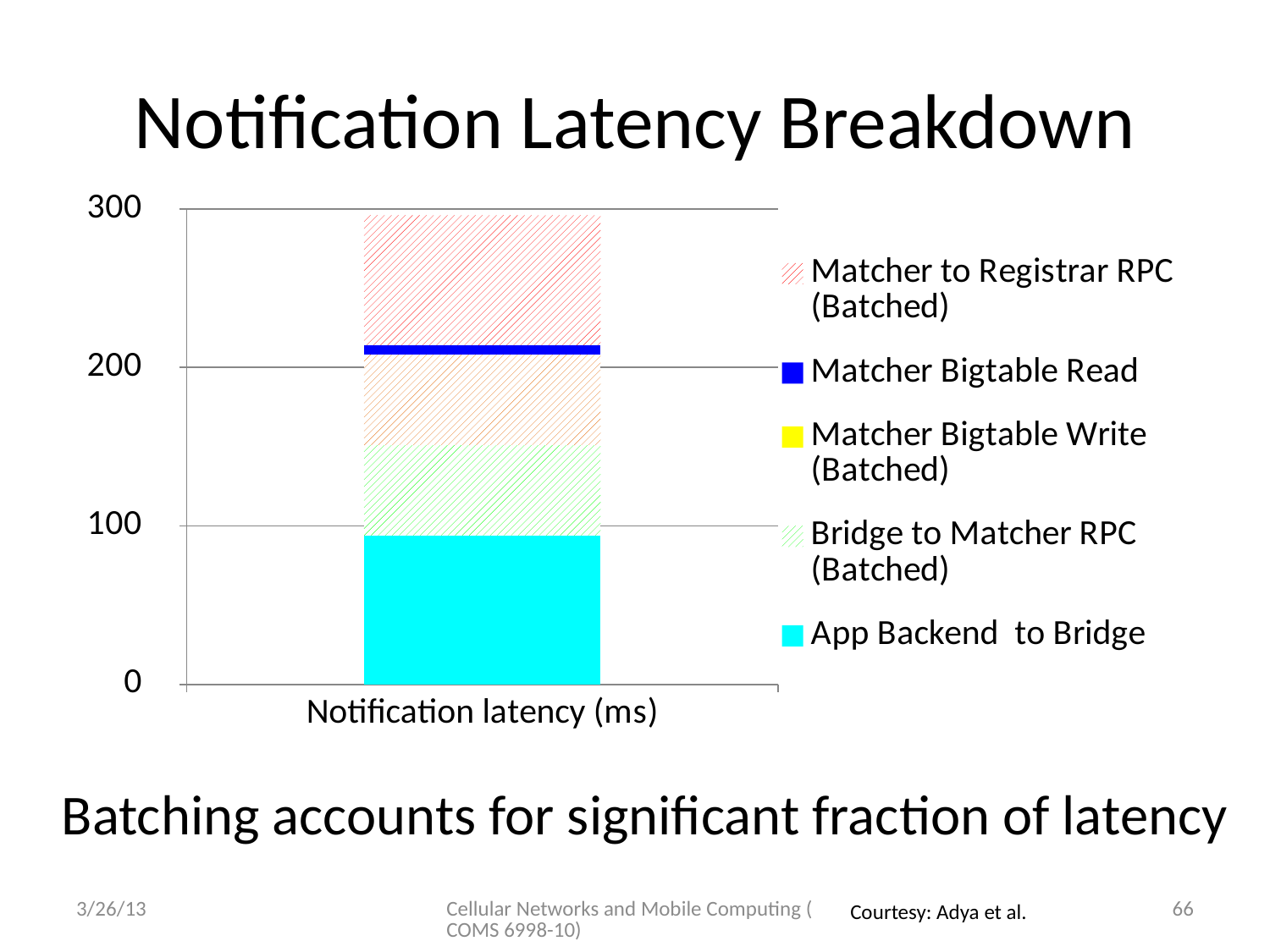
Is the total height of the stacked bar greater or less than 200? greater Which series is shown at the bottom of the stacked bar? App Backend to Bridge How many categories are plotted on the x axis? 1 What is the label of the category on the x axis? Notification latency (ms) Which segment is larger, Matcher to Registrar RPC (Batched) or Bridge to Matcher RPC (Batched)? Matcher to Registrar RPC (Batched) What kind of chart is shown on the slide? Stacked bar chart Is the value of the App Backend to Bridge segment greater or less than 100? less How many series does the chart legend list? 5 Is the total height of the stacked bar greater or less than 300? less Which segment is larger, Matcher to Registrar RPC (Batched) or Matcher Bigtable Read? Matcher to Registrar RPC (Batched) What is the title of the chart? Notification Latency Breakdown Which segment is larger, App Backend to Bridge or Matcher Bigtable Read? App Backend to Bridge